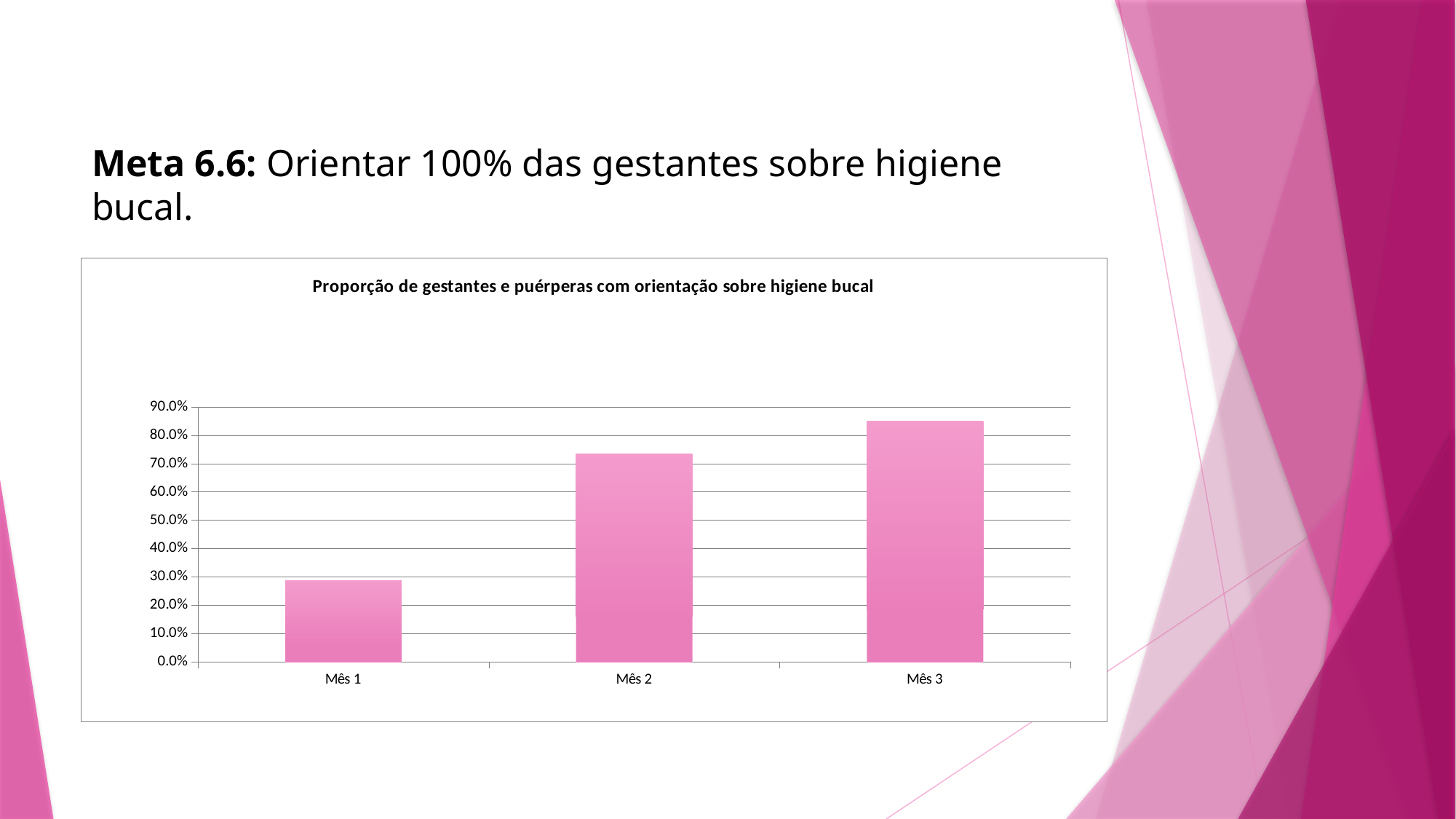
How many categories are shown on the x axis of the chart? 3 Do the values rise or fall from Mês 1 to Mês 3? rise Which month has the highest proportion in the chart? Mês 3 Which month has the lowest proportion in the chart? Mês 1 Is the value for Mês 2 greater or less than 70.0%? greater What is the title of the chart? Proporção de gestantes e puérperas com orientação sobre higiene bucal Is the value for Mês 1 greater or less than 30.0%? less What is the highest value shown on the y axis of the chart? 90.0% Is the value for Mês 3 greater or less than 80.0%? greater Which is larger, the value for Mês 1 or the value for Mês 2? Mês 2 What kind of chart is shown on the slide? bar chart